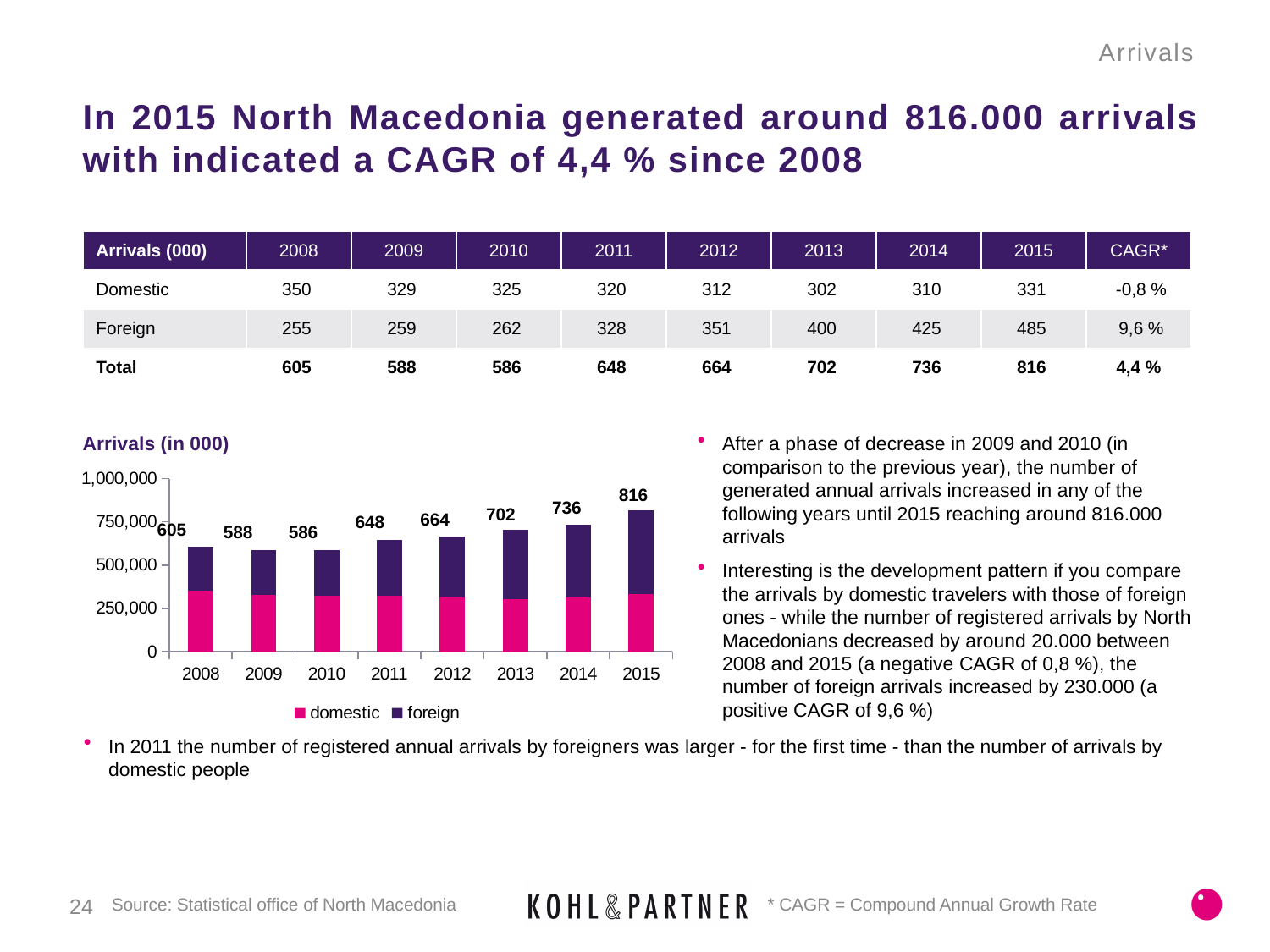
What type of chart is shown under the heading 'Arrivals (in 000)'? Stacked bar chart What is the total arrivals value labelled on the bar for 2012? 664 From 2010 to 2015, do the total arrivals in the chart rise or fall? Rise Which year has the lowest total arrivals in the chart? 2010 How many series does the chart legend list? 2 Which year has the highest total arrivals in the chart? 2015 Which year has a larger total arrivals value, 2011 or 2013? 2013 What is the difference between the total arrivals labelled for 2015 and for 2008? 211 What is the total arrivals value labelled on the bar for 2015? 816 Which series is shown in pink in the chart? domestic How many years are shown on the x axis of the chart? 8 What is the total arrivals value labelled on the bar for 2008? 605